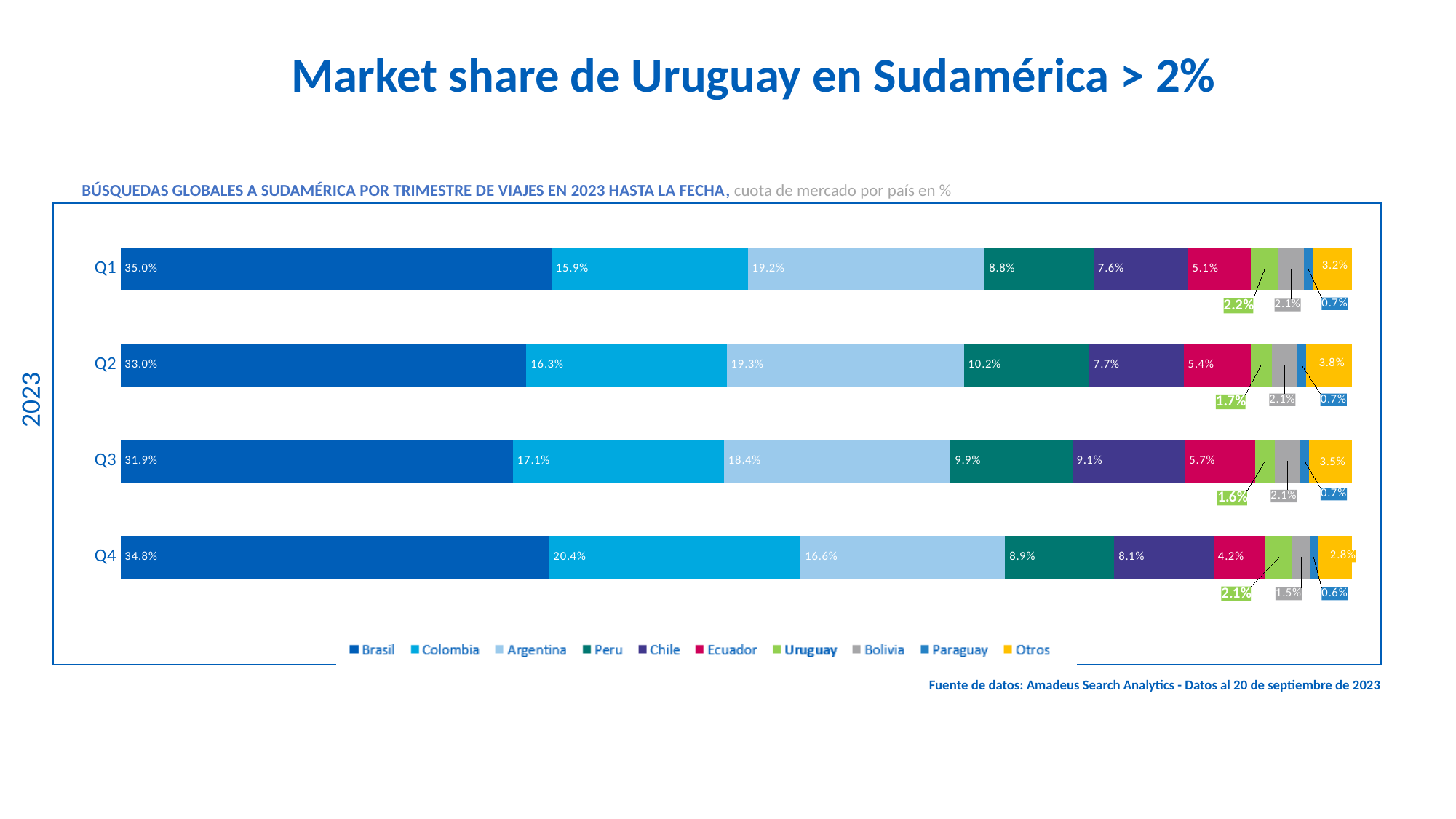
What is the market share of Brasil in Q1? 35.0% What is the market share of Peru in Q2? 10.2% What is the market share of Colombia in Q4? 20.4% What type of chart is shown on the slide? Stacked bar chart In which quarter is Brasil's market share lowest? Q3 Which is larger in Q3: the share of Chile or the share of Peru? Peru How many quarters are shown in the chart? 4 Which legend entry is shown in yellow? Otros In which quarter is Uruguay's market share highest? Q1 What is the difference between Argentina's share in Q2 and in Q4? 2.7% How many countries or categories does the legend list? 10 What is the market share of Uruguay in Q4? 2.1%